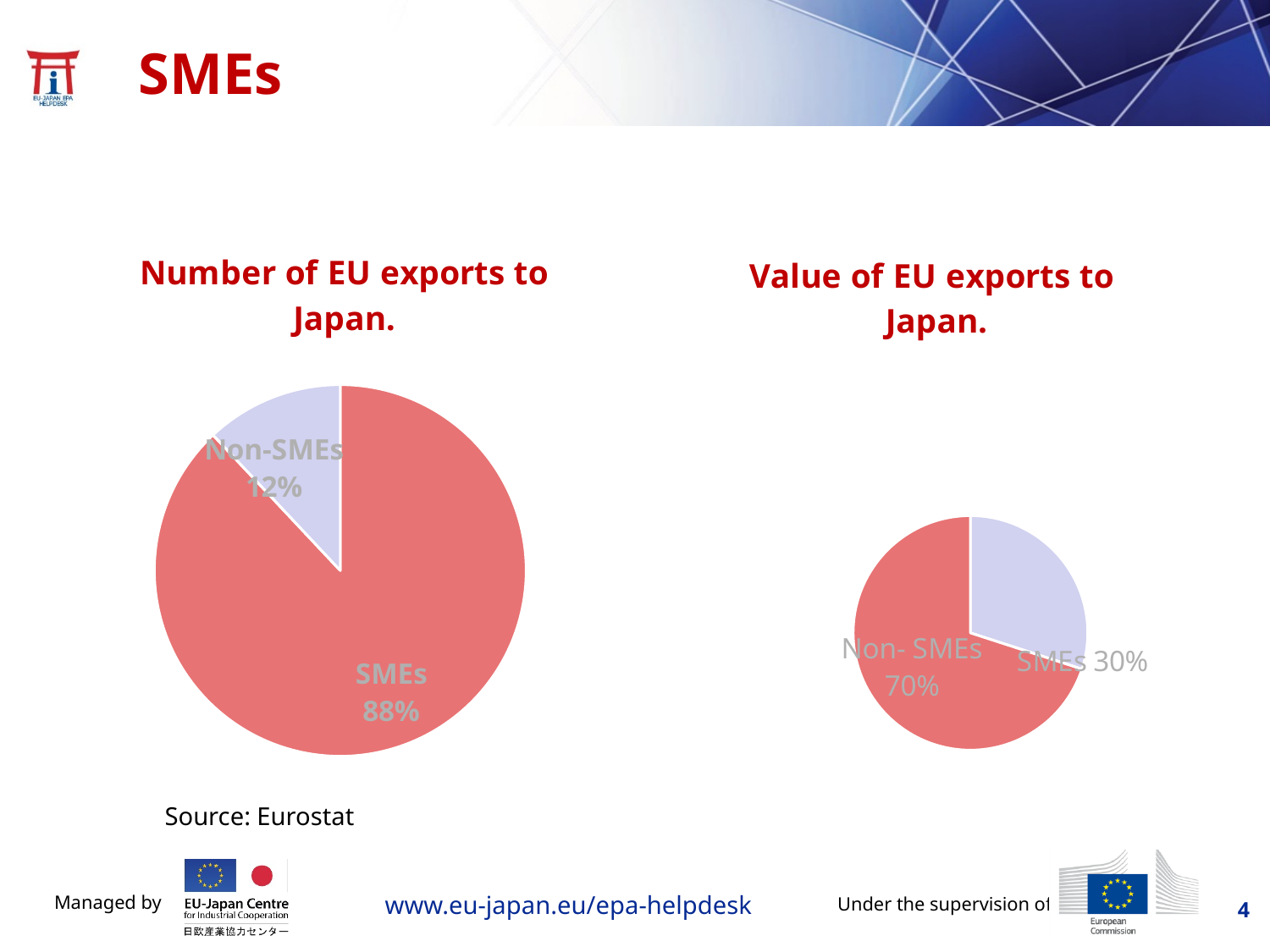
In the 'Value of EU exports to Japan' chart, which category has the smallest slice? SMEs In the 'Number of EU exports to Japan' chart, what is the difference in percentage points between the SMEs and Non-SMEs shares? 76 What type of chart is used on this slide? Pie chart What is the source cited for the charts on this slide? Eurostat In the 'Number of EU exports to Japan' chart, what share do Non-SMEs account for? 12% In the 'Value of EU exports to Japan' chart, what is the difference in percentage points between the Non-SMEs and SMEs shares? 40 How many categories does the 'Value of EU exports to Japan' chart show? 2 In the 'Number of EU exports to Japan' chart, which category has the largest slice? SMEs In the 'Number of EU exports to Japan' chart, what share do SMEs account for? 88% In the 'Value of EU exports to Japan' chart, what share do SMEs account for? 30% Is the SMEs share larger in the 'Number of EU exports to Japan' chart or in the 'Value of EU exports to Japan' chart? Number of EU exports to Japan In the 'Value of EU exports to Japan' chart, what share do Non-SMEs account for? 70%